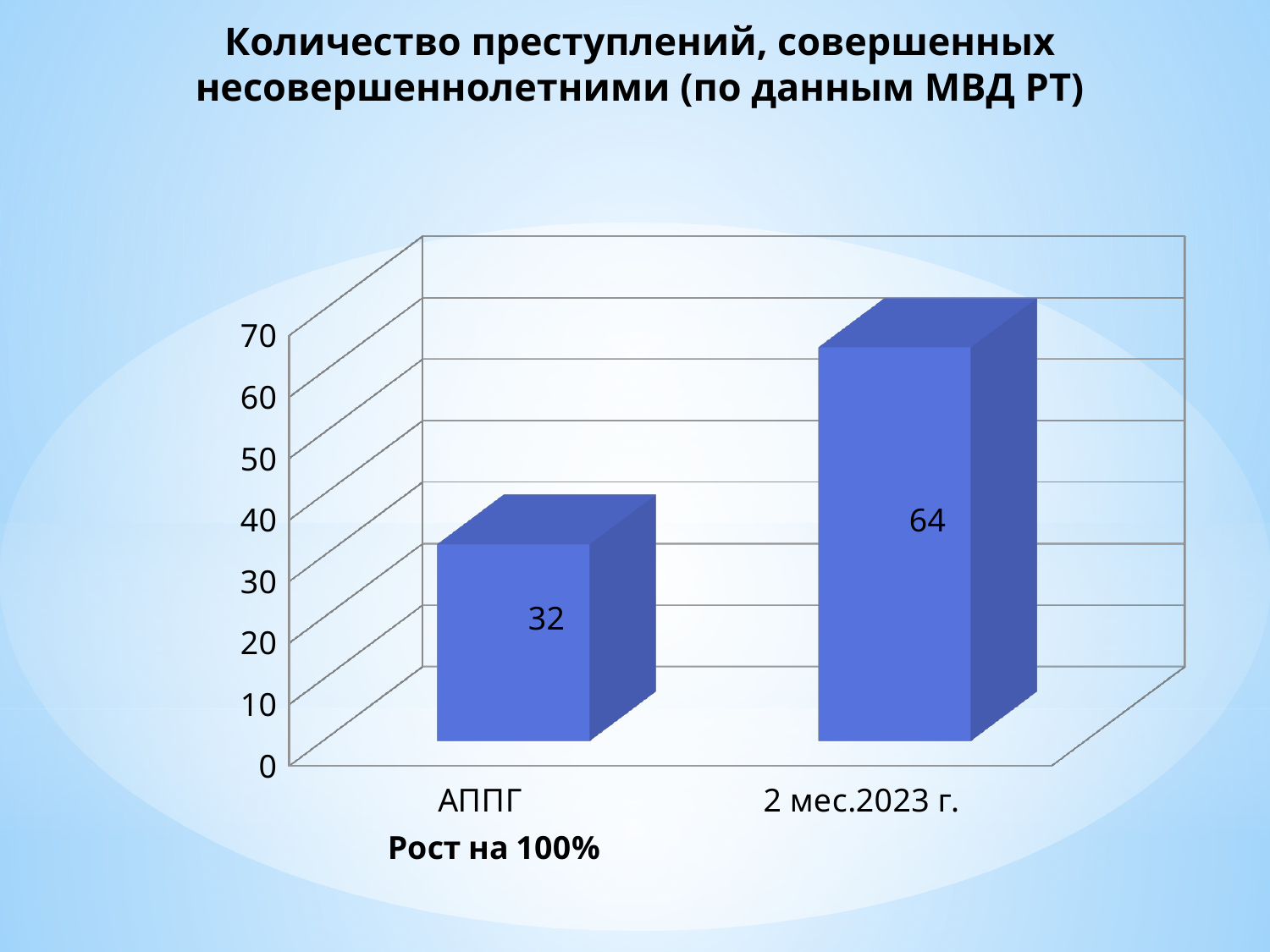
How many categories are shown on the x axis? 2 Which category has the highest value? 2 мес.2023 г. Do the values rise or fall from АППГ to 2 мес.2023 г.? rise What is the title of the chart? Количество преступлений, совершенных несовершеннолетними (по данным МВД РТ) Which is larger, the value for АППГ or the value for 2 мес.2023 г.? 2 мес.2023 г. What is the value for 2 мес.2023 г.? 64 What is the difference between the values for 2 мес.2023 г. and АППГ? 32 What kind of chart is shown on the slide? bar chart Which category has the lowest value? АППГ What is the value for АППГ? 32 Is the value for АППГ greater or less than 40? less Is the value for 2 мес.2023 г. greater or less than 50? greater